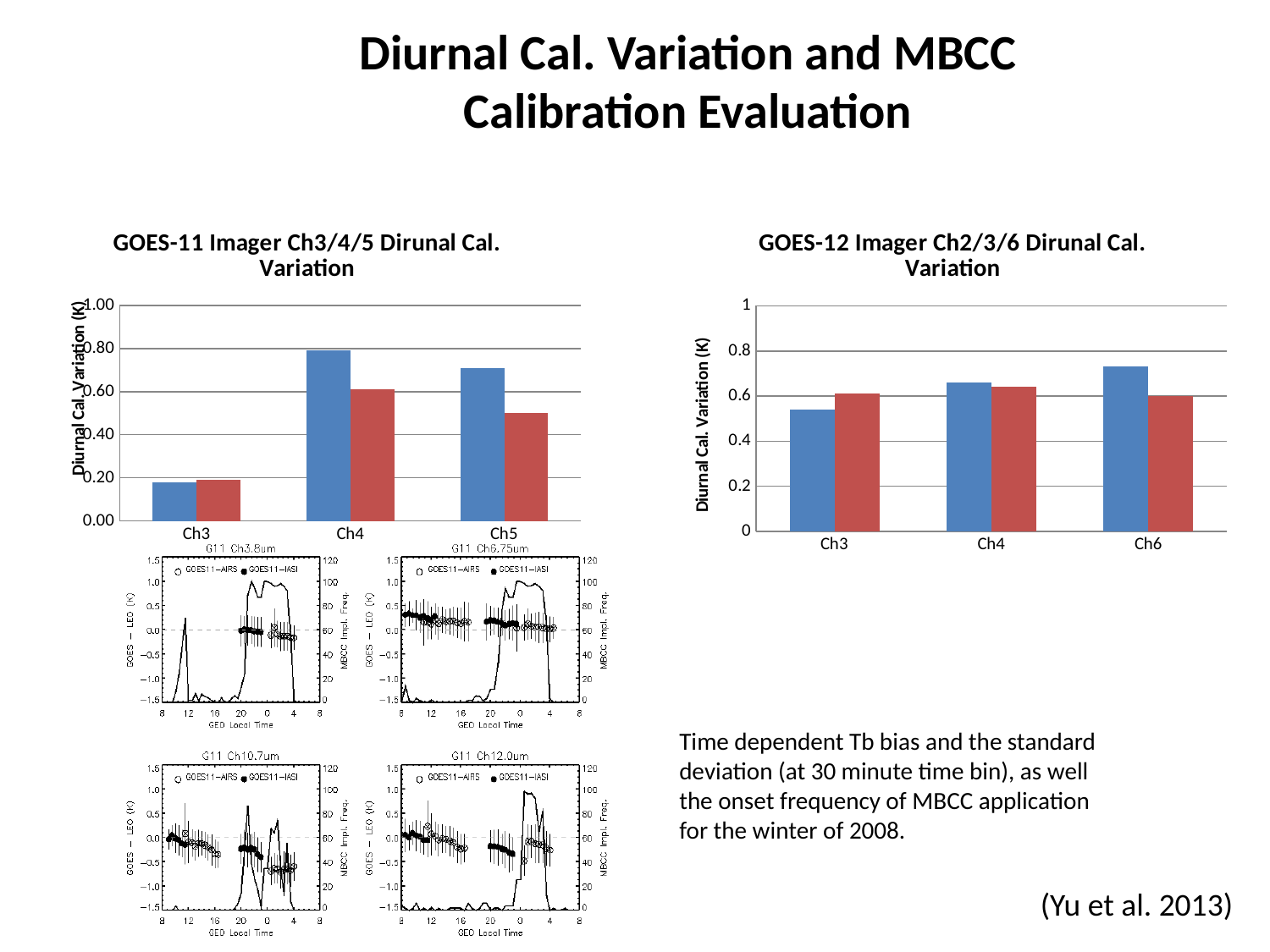
In the 'GOES-11 Imager Ch3/4/5 Dirunal Cal. Variation' chart, which channel has the shortest blue bar? Ch3 In the 'GOES-11 Imager Ch3/4/5 Dirunal Cal. Variation' chart, for Ch5, which bar is taller, the blue one or the red one? blue In the 'GOES-12 Imager Ch2/3/6 Dirunal Cal. Variation' chart, is the blue bar for Ch6 greater or less than 0.6? greater In the 'GOES-11 Imager Ch3/4/5 Dirunal Cal. Variation' chart, which channel has the tallest blue bar? Ch4 In the 'GOES-12 Imager Ch2/3/6 Dirunal Cal. Variation' chart, do the blue bars rise or fall from Ch3 to Ch6? rise How many channel categories are shown on the x axis of the 'GOES-12 Imager Ch2/3/6 Dirunal Cal. Variation' chart? 3 In the 'GOES-11 Imager Ch3/4/5 Dirunal Cal. Variation' chart, is the red bar for Ch3 greater or less than 0.40? less In the 'GOES-12 Imager Ch2/3/6 Dirunal Cal. Variation' chart, which channel has the tallest blue bar? Ch6 What is the y-axis label of the 'GOES-12 Imager Ch2/3/6 Dirunal Cal. Variation' chart? Diurnal Cal. Variation (K) What kind of chart is the 'GOES-11 Imager Ch3/4/5 Dirunal Cal. Variation' chart? bar chart How many channel categories are shown on the x axis of the 'GOES-11 Imager Ch3/4/5 Dirunal Cal. Variation' chart? 3 In the 'GOES-11 Imager Ch3/4/5 Dirunal Cal. Variation' chart, is the blue bar for Ch4 greater or less than 0.60? greater